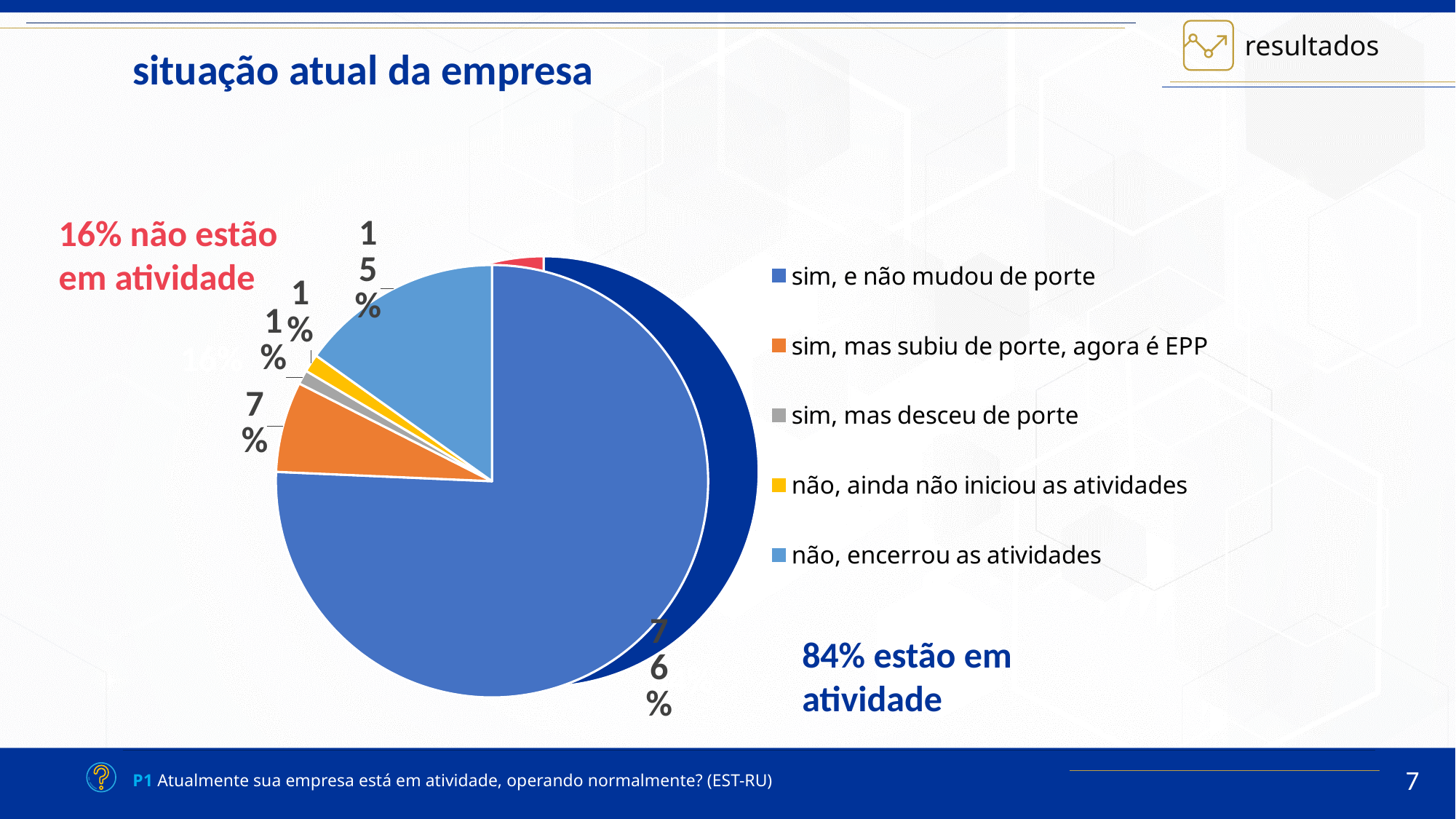
What percentage of the pie corresponds to "sim, mas subiu de porte, agora é EPP"? 7% What colour is the slice for "não, ainda não iniciou as atividades"? yellow How many categories does the legend list? 5 What kind of chart is shown on the slide? pie chart What is the difference in percentage points between "sim, e não mudou de porte" and "não, encerrou as atividades"? 61 What percentage of the pie corresponds to "não, encerrou as atividades"? 15% What is the title of the slide containing the chart? situação atual da empresa Which category has the largest slice of the pie? sim, e não mudou de porte Which slice is larger: "sim, mas subiu de porte, agora é EPP" or "não, encerrou as atividades"? não, encerrou as atividades What is the combined share of the three "sim" categories? 84% What percentage of the pie corresponds to "sim, e não mudou de porte"? 76% What percentage of the pie corresponds to "sim, mas desceu de porte"? 1%